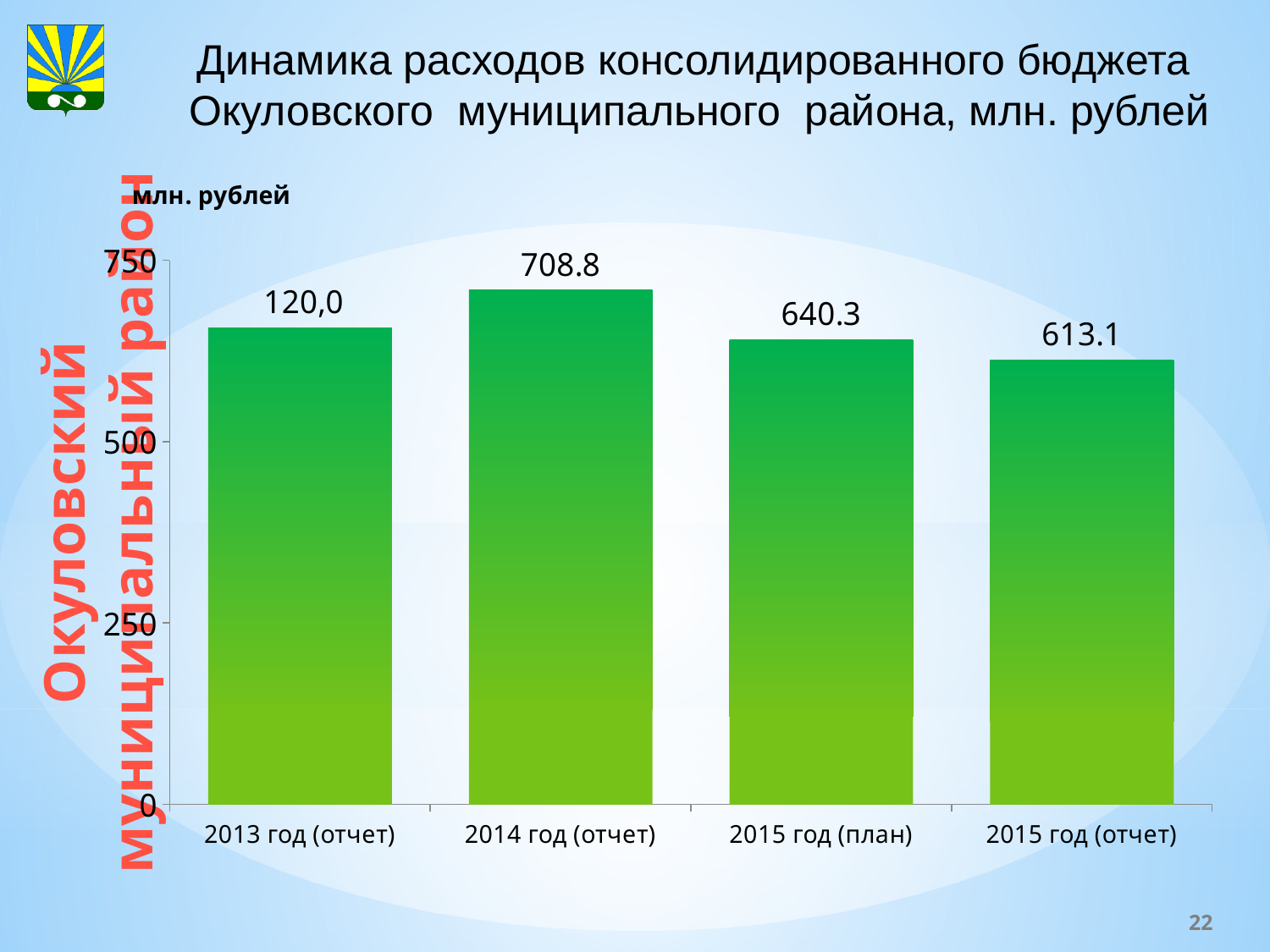
Which category has the highest bar? 2014 год (отчет) Is the bar for 2013 год (отчет) greater or less than 500? greater What is the difference between the values for 2015 год (план) and 2015 год (отчет)? 27.2 What is the value for 2015 год (отчет)? 613.1 How many categories are shown on the x axis? 4 What kind of chart is shown on the slide? bar chart Do the values rise or fall from 2014 год (отчет) to 2015 год (отчет)? fall What is the value for 2015 год (план)? 640.3 Which is larger, the value for 2015 год (план) or 2015 год (отчет)? 2015 год (план) What is the value for 2014 год (отчет)? 708.8 What unit is shown above the vertical axis of the chart? млн. рублей What is the difference between the values for 2014 год (отчет) and 2015 год (план)? 68.5